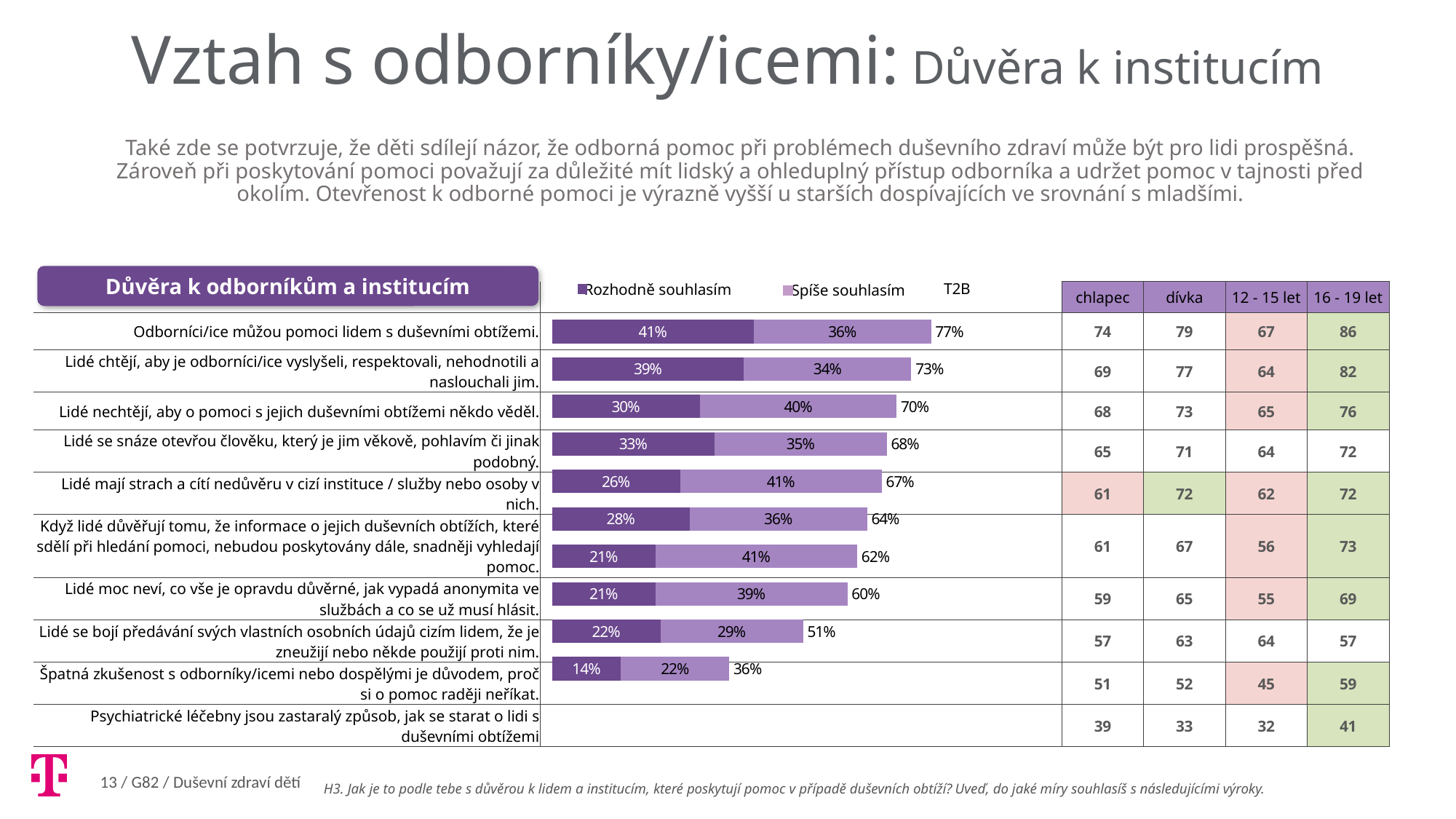
What is the lowest T2B value shown in the chart? 36% What is the 'Rozhodně souhlasím' value for 'Odborníci/ice můžou pomoci lidem s duševními obtížemi'? 41% What is the 'Spíše souhlasím' value for 'Lidé mají strach a cítí nedůvěru v cizí instituce / služby nebo osoby v nich'? 41% Which statement has the highest T2B value in the chart? Odborníci/ice můžou pomoci lidem s duševními obtížemi. For 'Lidé nechtějí, aby o pomoci s jejich duševními obtížemi někdo věděl', which is larger: 'Rozhodně souhlasím' or 'Spíše souhlasím'? Spíše souhlasím What is the 'Spíše souhlasím' value for 'Odborníci/ice můžou pomoci lidem s duševními obtížemi'? 36% What kind of chart is shown on the slide? bar chart What is the difference in 'Rozhodně souhlasím' between 'Odborníci/ice můžou pomoci lidem s duševními obtížemi' and 'Lidé chtějí, aby je odborníci/ice vyslyšeli, respektovali, nehodnotili a naslouchali jim'? 2 percentage points How many series does the chart legend list? 2 What is the T2B total for the bar for 'Odborníci/ice můžou pomoci lidem s duševními obtížemi'? 77% How many bars are plotted in the chart? 10 Do the T2B totals rise or fall going from the top bar to the bottom bar? fall